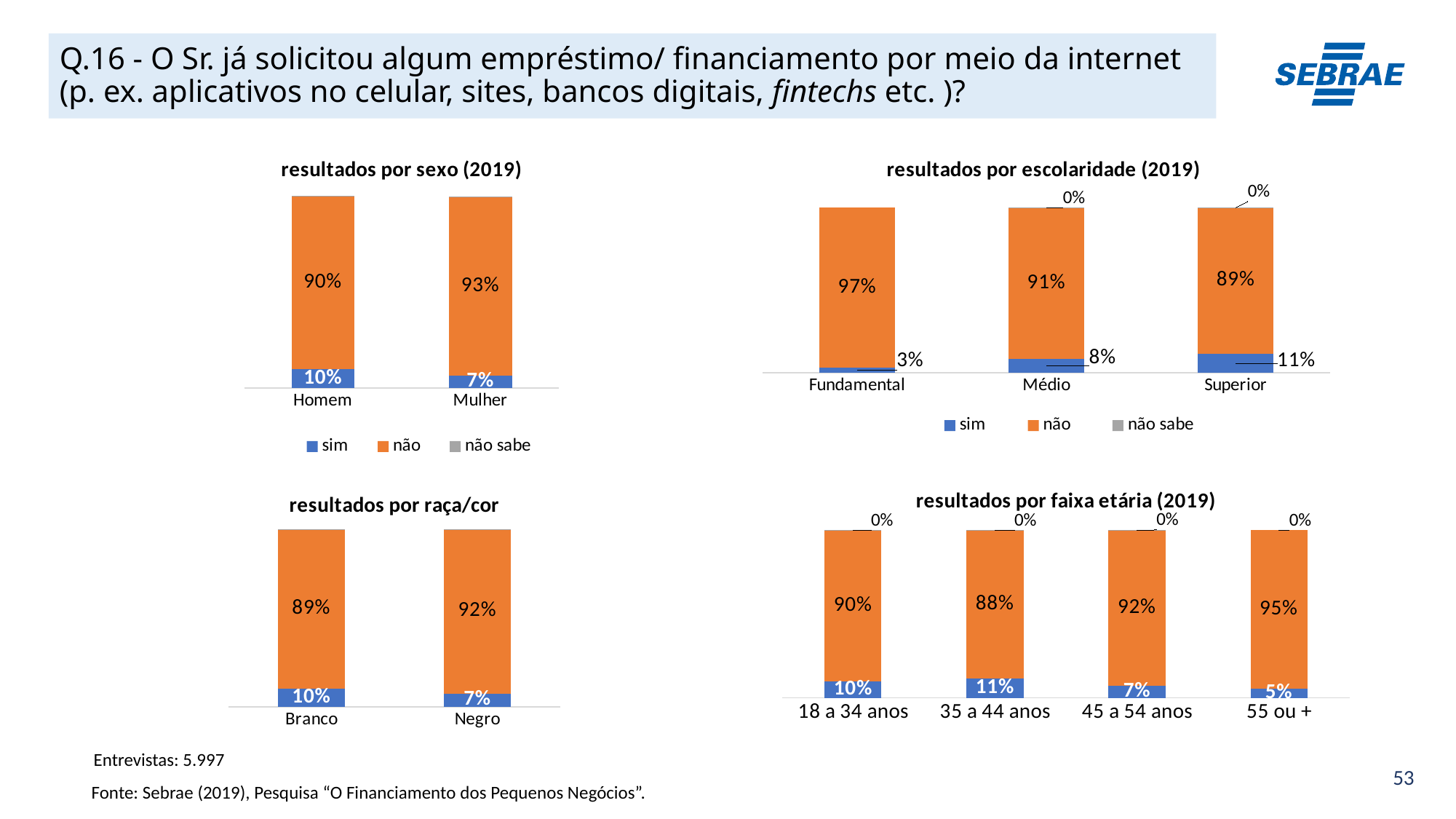
In the chart 'resultados por raça/cor', what is the 'não' value for Branco? 89% In the chart 'resultados por escolaridade (2019)', what is the 'não' value for Fundamental? 97% What kind of chart is 'resultados por faixa etária (2019)'? Stacked bar chart In the chart 'resultados por raça/cor', which category has the larger 'sim' value, Branco or Negro? Branco In the chart 'resultados por sexo (2019)', what is the 'sim' value for Homem? 10% In the chart 'resultados por faixa etária (2019)', which age group has the lowest 'sim' value? 55 ou + In the chart 'resultados por escolaridade (2019)', how many categories are shown on the x axis? 3 In the chart 'resultados por sexo (2019)', what is the 'não' value for Mulher? 93% In the chart 'resultados por escolaridade (2019)', what is the difference between the 'sim' values for Superior and Fundamental? 8% In the chart 'resultados por escolaridade (2019)', which category has the highest 'sim' value? Superior In the chart 'resultados por faixa etária (2019)', what is the 'não' value for 35 a 44 anos? 88%